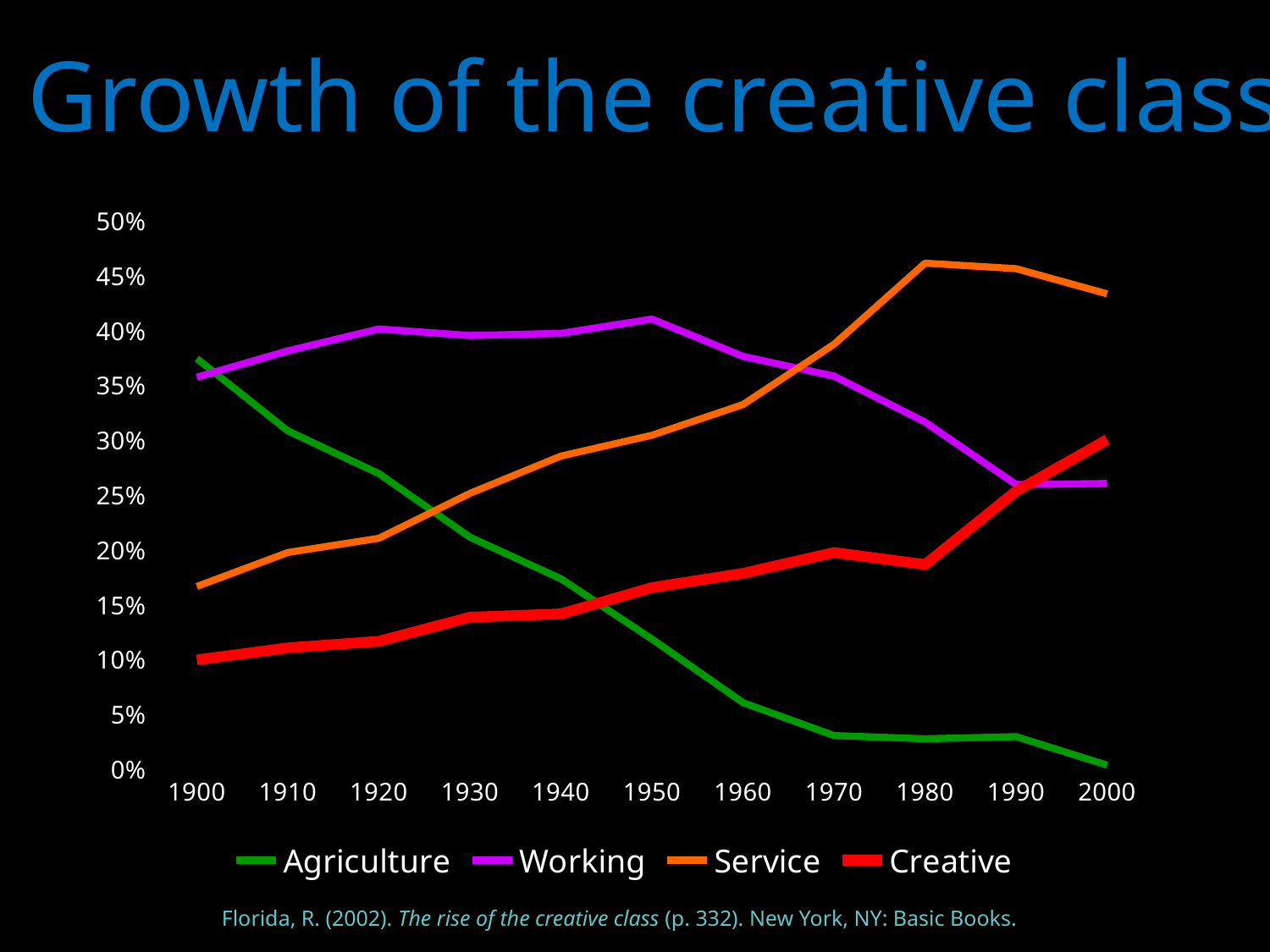
Which series has the lowest value in 2000? Agriculture How many years are marked along the x axis? 11 What kind of chart is shown on the slide? line chart Does the Service line generally rise or fall from 1900 to 1980? rise Is the value for Service in 1980 greater or less than 40%? greater Is the value for Working in 1920 greater or less than 35%? greater In 2000, which is larger, the Service value or the Working value? Service Which series has the highest value in 1950? Working Is the value for Creative in 2000 greater or less than 25%? greater How many series does the legend list? 4 Does the Agriculture line rise or fall from 1900 to 2000? fall